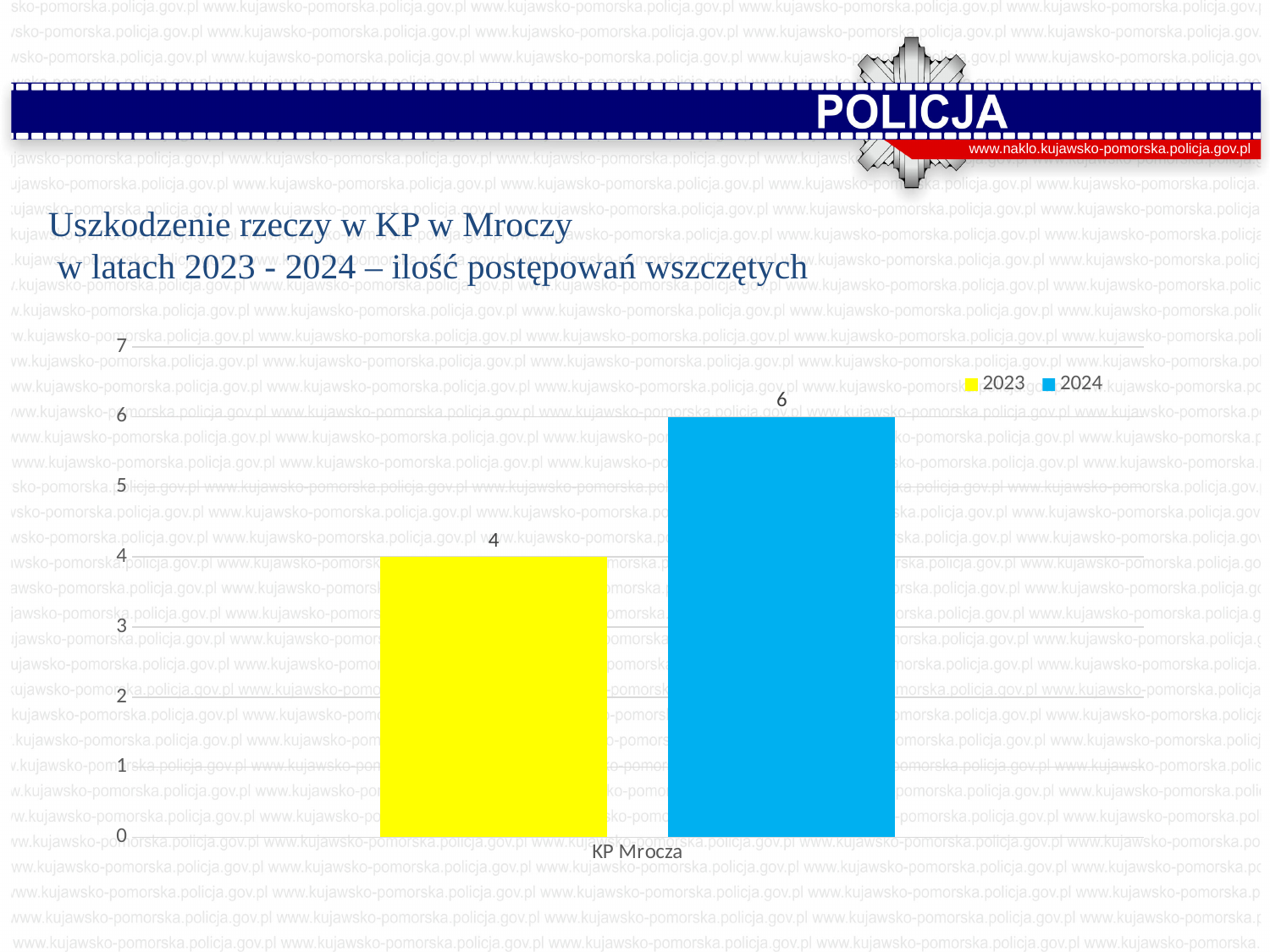
How many categories are shown on the x axis? 1 Is the value for 2023 greater or less than 5? less What is the difference between the 2024 and 2023 values? 2 How many series does the legend list? 2 What colour is the bar for 2023? yellow Which series has the lowest value in the chart? 2023 What is the value for 2023 in the chart? 4 What is the category label on the x axis? KP Mrocza Which year has the higher value, 2023 or 2024? 2024 What kind of chart is shown on the slide? bar chart What is the value for 2024 in the chart? 6 Is the value for 2024 greater or less than 5? greater